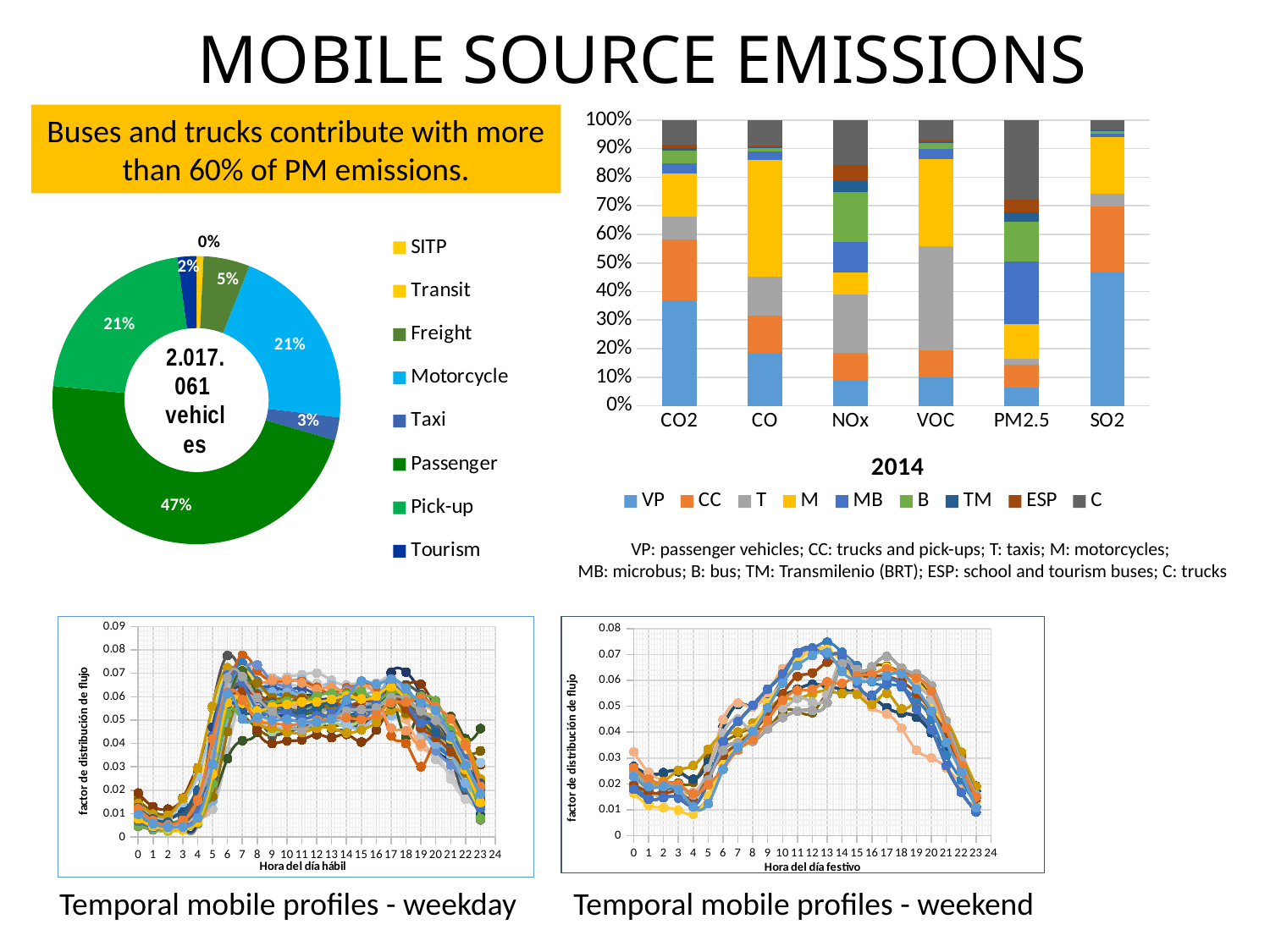
In the stacked bar chart titled 2014, is the VP share of SO2 greater or less than 40%? greater In the stacked bar chart titled 2014, how many series does the legend list? 9 In the donut chart on the left, which is larger, the Freight share or the Taxi share? Freight In the donut chart on the left, what share of vehicles is Taxi? 3% In the donut chart on the left, what share of vehicles is Motorcycle? 21% In the stacked bar chart titled 2014, how many pollutant categories are shown on the x axis? 6 In the donut chart on the left, how many percentage points larger is the Passenger share than the Motorcycle share? 26 percentage points In the stacked bar chart titled 2014, for which pollutant is the VP share the largest? SO2 What total number of vehicles is printed in the centre of the donut chart? 2.017.061 vehicles What kind of chart is the 'Temporal mobile profiles - weekday' chart at the bottom left? line chart In the donut chart on the left, which vehicle category has the largest share? Passenger In the donut chart on the left, what share of vehicles is Passenger? 47%